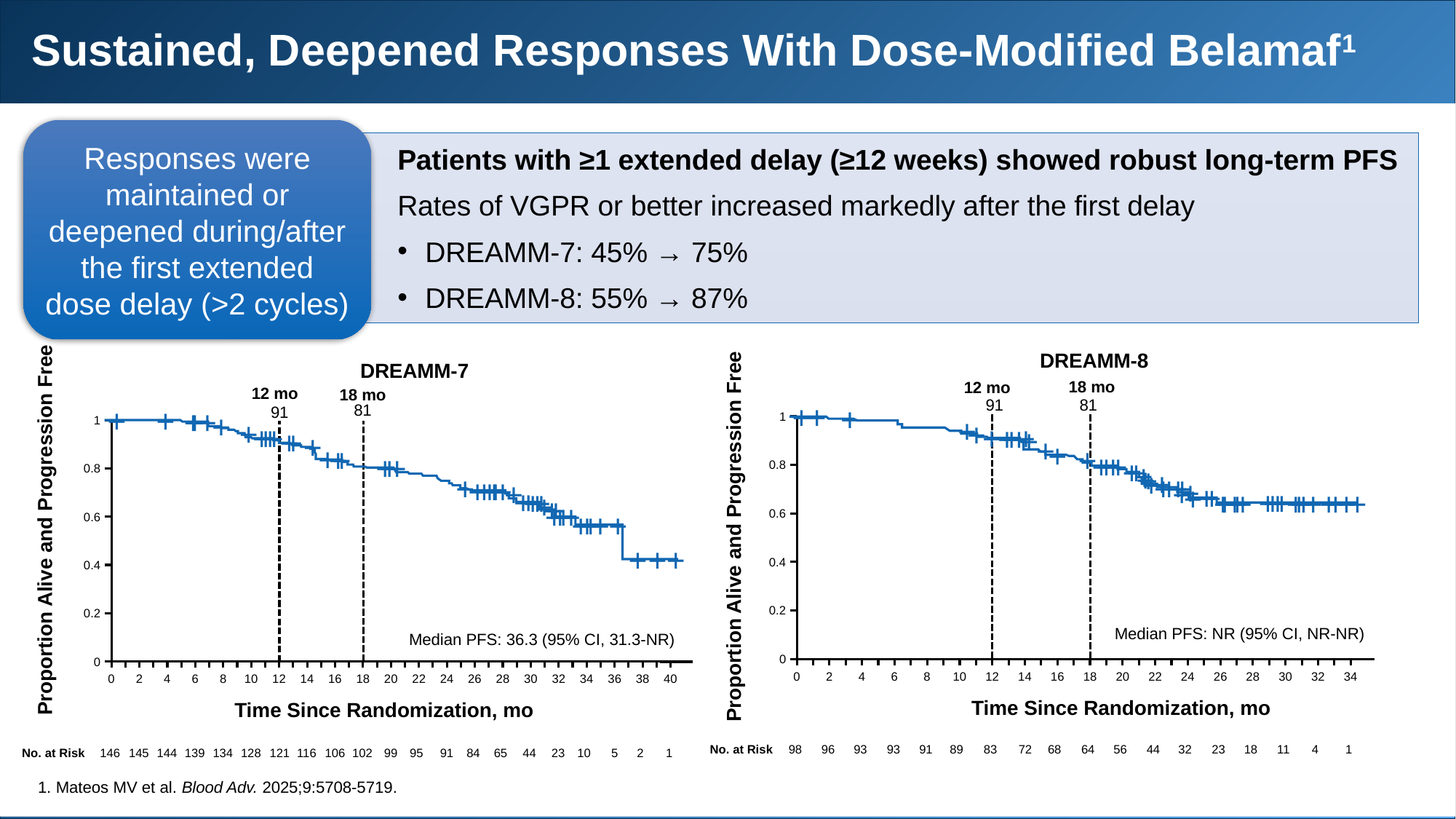
On the DREAMM-7 chart, what value is labeled at the 18 mo dashed line? 81 On the DREAMM-8 chart, what value is labeled at the 18 mo dashed line? 81 On the DREAMM-8 chart, what is the median PFS shown? NR (95% CI, NR-NR) On the DREAMM-8 chart, what value is labeled at the 12 mo dashed line? 91 What kind of chart is the DREAMM-7 chart? line chart On the DREAMM-8 chart, is the proportion alive and progression free at 30 months greater or less than 0.8? less Which chart has the larger number at risk at time 0, DREAMM-7 (146) or DREAMM-8 (98)? DREAMM-7 On the DREAMM-7 chart, is the proportion alive and progression free at 38 months greater or less than 0.6? less On the DREAMM-7 chart, what value is labeled at the 12 mo dashed line? 91 On the DREAMM-7 chart, what is the difference between the 12 mo value and the 18 mo value? 10 On the DREAMM-7 chart, what is the median PFS shown? 36.3 (95% CI, 31.3-NR) On the DREAMM-8 chart, does the curve rise or fall as time since randomization increases? fall